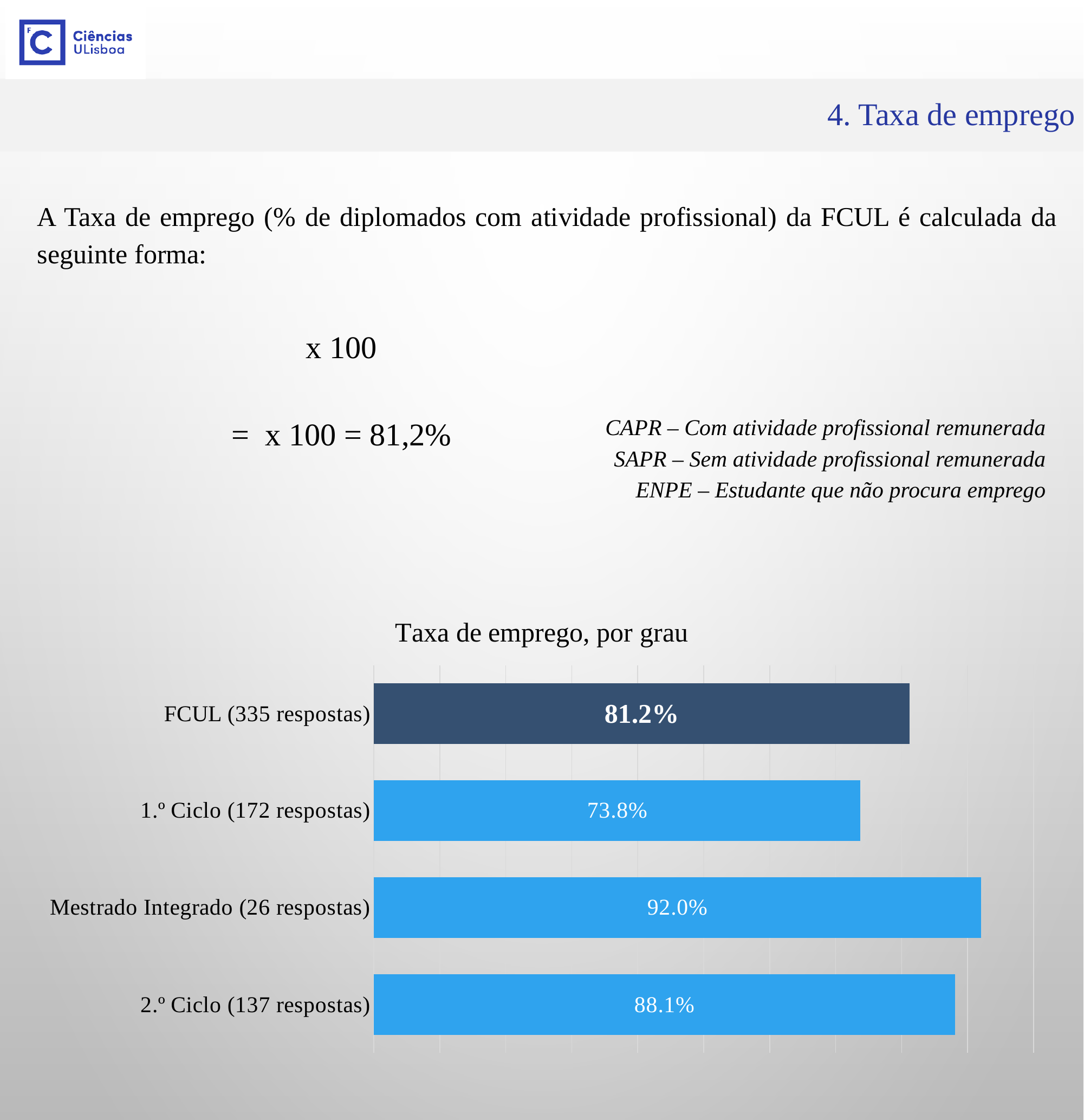
What is the employment rate shown for 1.º Ciclo (172 respostas)? 73.8% Which category has the highest employment rate in the chart? Mestrado Integrado (26 respostas) What type of chart is shown on the slide? Bar chart How many categories are shown in the chart? 4 What is the difference between the employment rates of 2.º Ciclo and FCUL? 6.9% What is the title of the chart? Taxa de emprego, por grau Which has a higher employment rate, 2.º Ciclo or 1.º Ciclo? 2.º Ciclo What is the difference between the employment rates of Mestrado Integrado and 1.º Ciclo? 18.2% What is the employment rate shown for 2.º Ciclo (137 respostas)? 88.1% Which category has the lowest employment rate in the chart? 1.º Ciclo (172 respostas) What is the employment rate shown for FCUL (335 respostas)? 81.2% What is the employment rate shown for Mestrado Integrado (26 respostas)? 92.0%